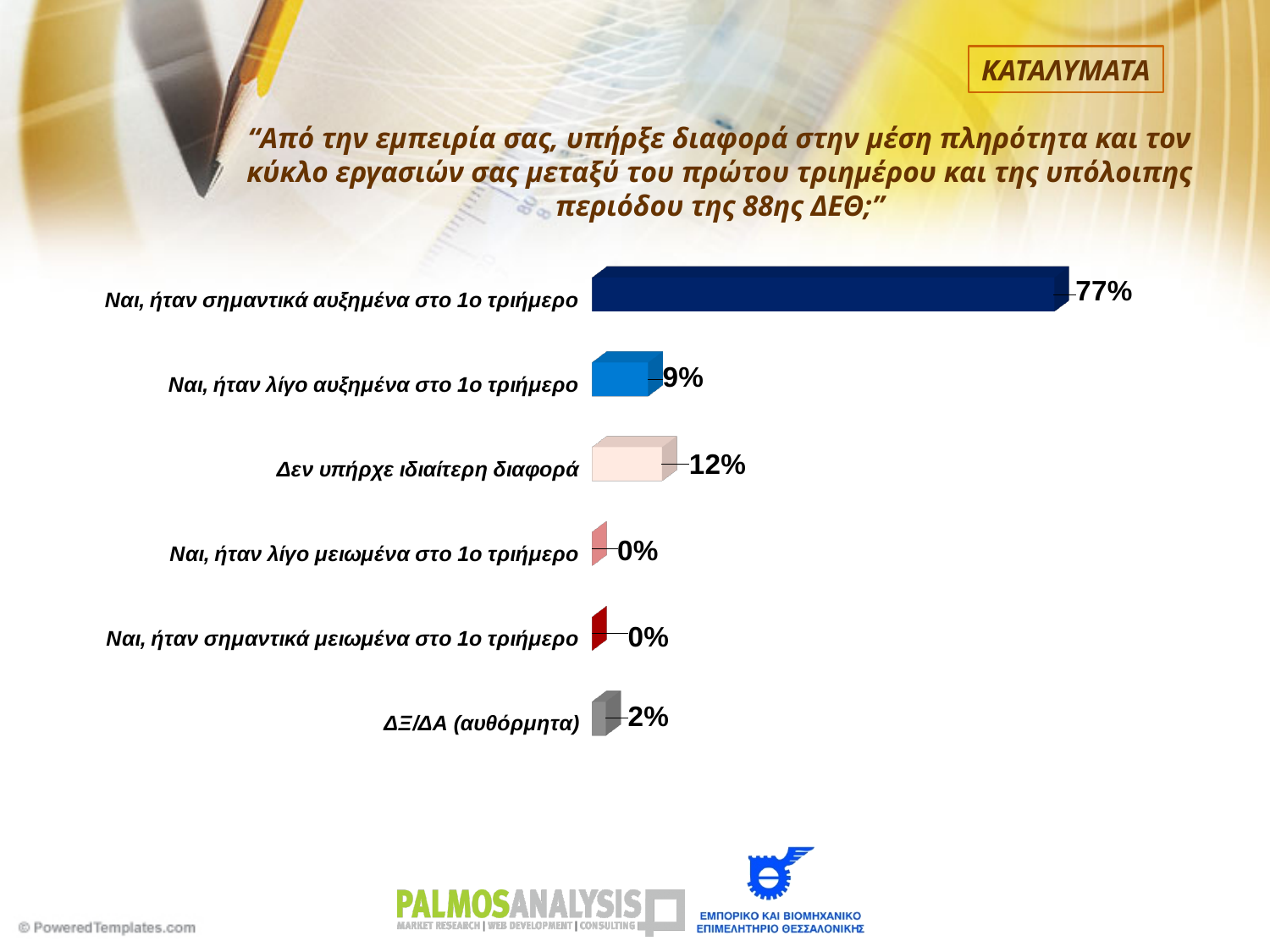
What kind of chart is shown on the slide? Bar chart What is the label in the box at the top right of the slide? ΚΑΤΑΛΥΜΑΤΑ How many categories are shown in the chart? 6 What is the value shown for "Ναι, ήταν λίγο αυξημένα στο 1ο τριήμερο"? 9% How many categories have a value of 0%? 2 What is the difference between the values for "Ναι, ήταν σημαντικά αυξημένα στο 1ο τριήμερο" and "Δεν υπήρχε ιδιαίτερη διαφορά"? 65% What is the value shown for "Δεν υπήρχε ιδιαίτερη διαφορά"? 12% What is the difference between the values for "Δεν υπήρχε ιδιαίτερη διαφορά" and "Ναι, ήταν λίγο αυξημένα στο 1ο τριήμερο"? 3% Which is larger: the value for "Δεν υπήρχε ιδιαίτερη διαφορά" or the value for "Ναι, ήταν λίγο αυξημένα στο 1ο τριήμερο"? Δεν υπήρχε ιδιαίτερη διαφορά Which category has the highest value? Ναι, ήταν σημαντικά αυξημένα στο 1ο τριήμερο What percentage of respondents answered "Ναι, ήταν σημαντικά αυξημένα στο 1ο τριήμερο"? 77% What is the value shown for "ΔΞ/ΔΑ (αυθόρμητα)"? 2%